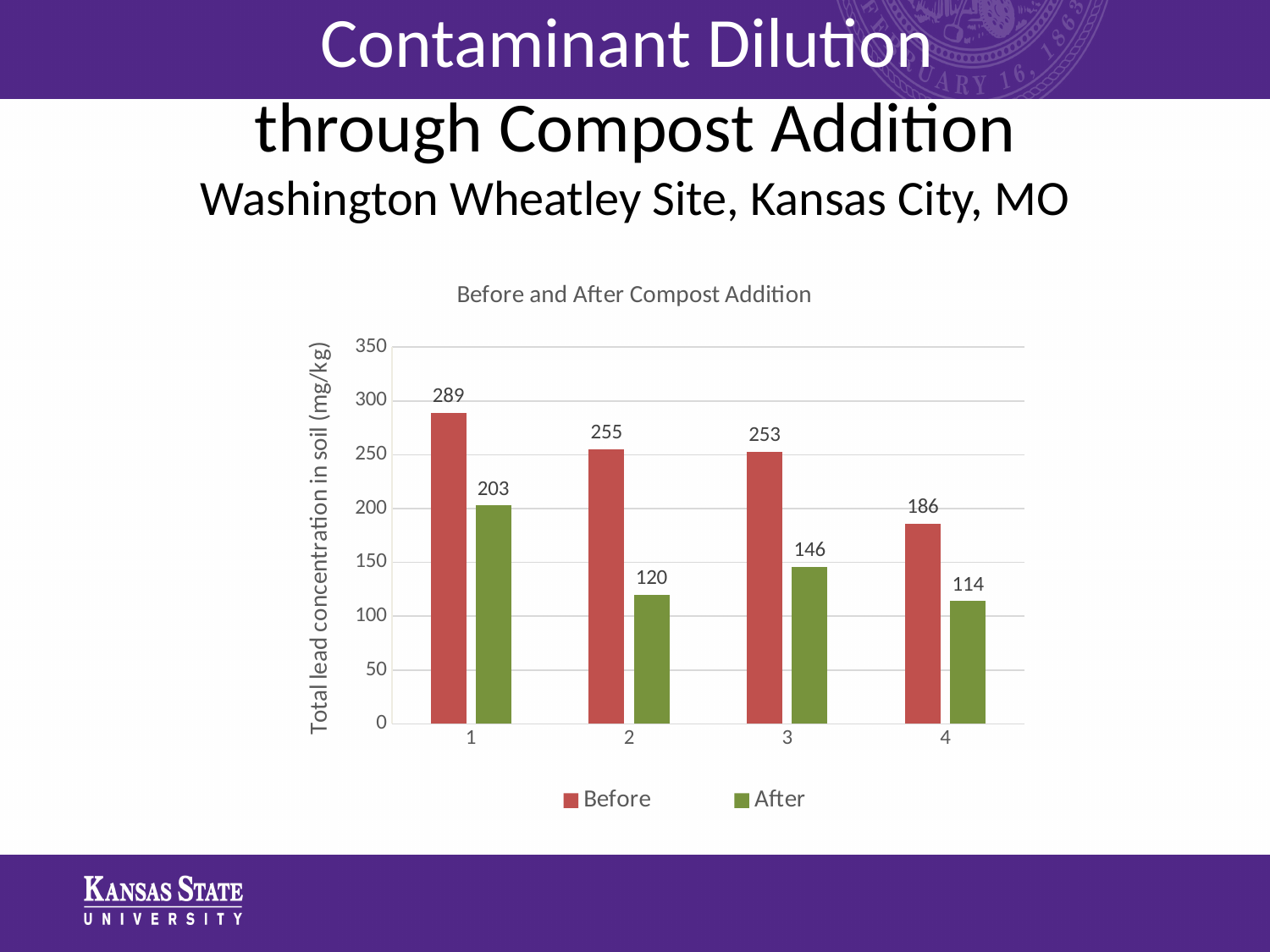
What is the After value for category 3? 146 What is the title of the chart? Before and After Compost Addition How many categories are shown on the x axis? 4 Which category has the highest Before value? 1 What is the Before value for category 1? 289 Do the Before values rise or fall from category 1 to category 4? Fall Which category has the lowest After value? 4 What is the difference between the Before and After values for category 2? 135 Which is larger: the After value for category 1 or the Before value for category 4? After value for category 1 What is the After value for category 4? 114 What kind of chart is shown on the slide? Bar chart How many series does the legend list? 2